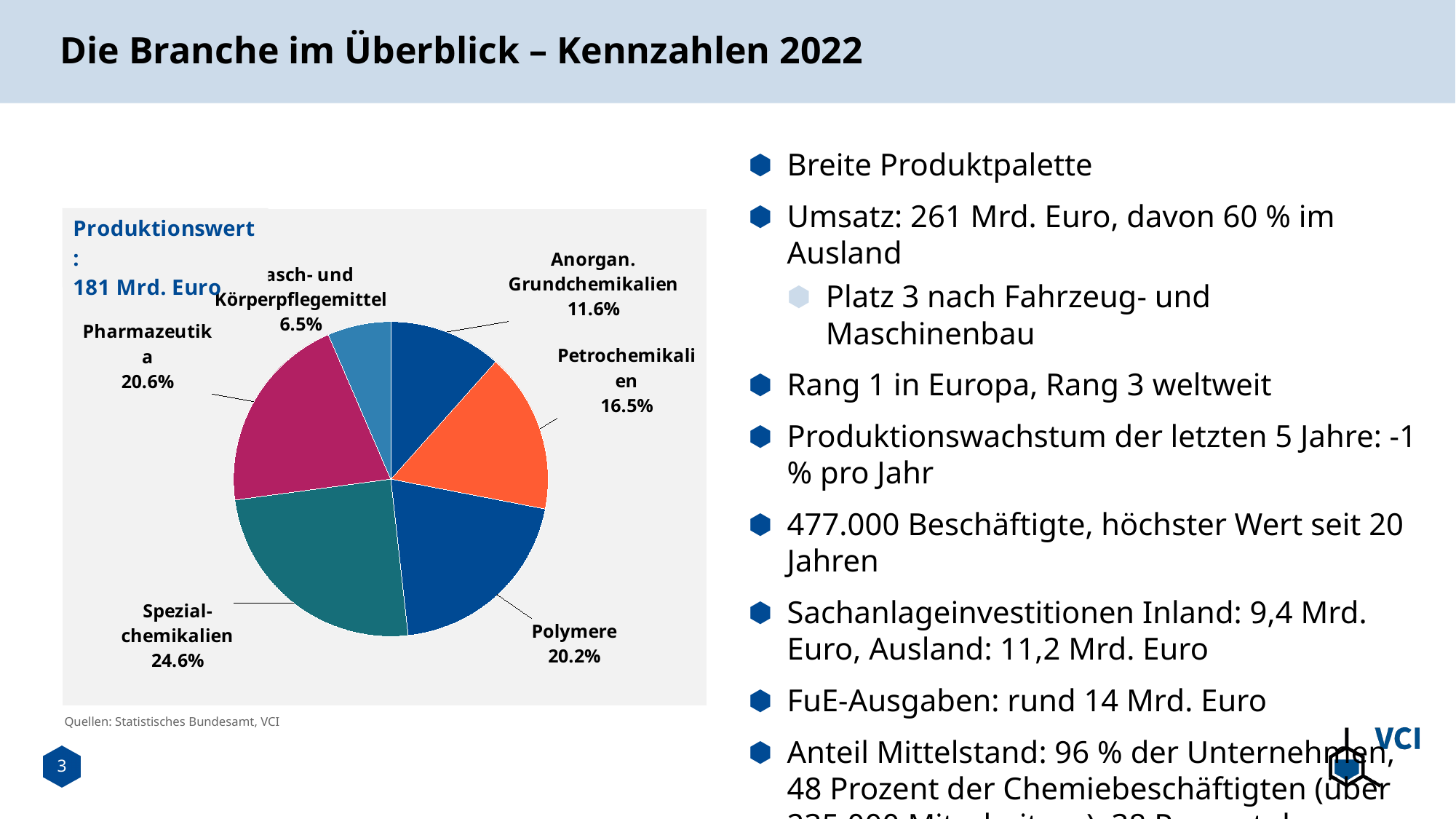
What percentage is shown for Polymere in the pie chart? 20.2% What type of chart is shown on the slide? pie chart Which has the larger share, Pharmazeutika or Petrochemikalien? Pharmazeutika What total Produktionswert is stated in the chart's title? 181 Mrd. Euro What percentage is shown for Pharmazeutika? 20.6% What share of the Produktionswert does Spezialchemikalien account for? 24.6% What is the difference in percentage points between Spezialchemikalien and Polymere? 4.4 percentage points What share does Anorgan. Grundchemikalien have in the pie chart? 11.6% What percentage is shown for Petrochemikalien? 16.5% Which category has the smallest slice of the pie chart? Wasch- und Körperpflegemittel Which category has the largest slice of the pie chart? Spezialchemikalien How many slices does the pie chart have? 6